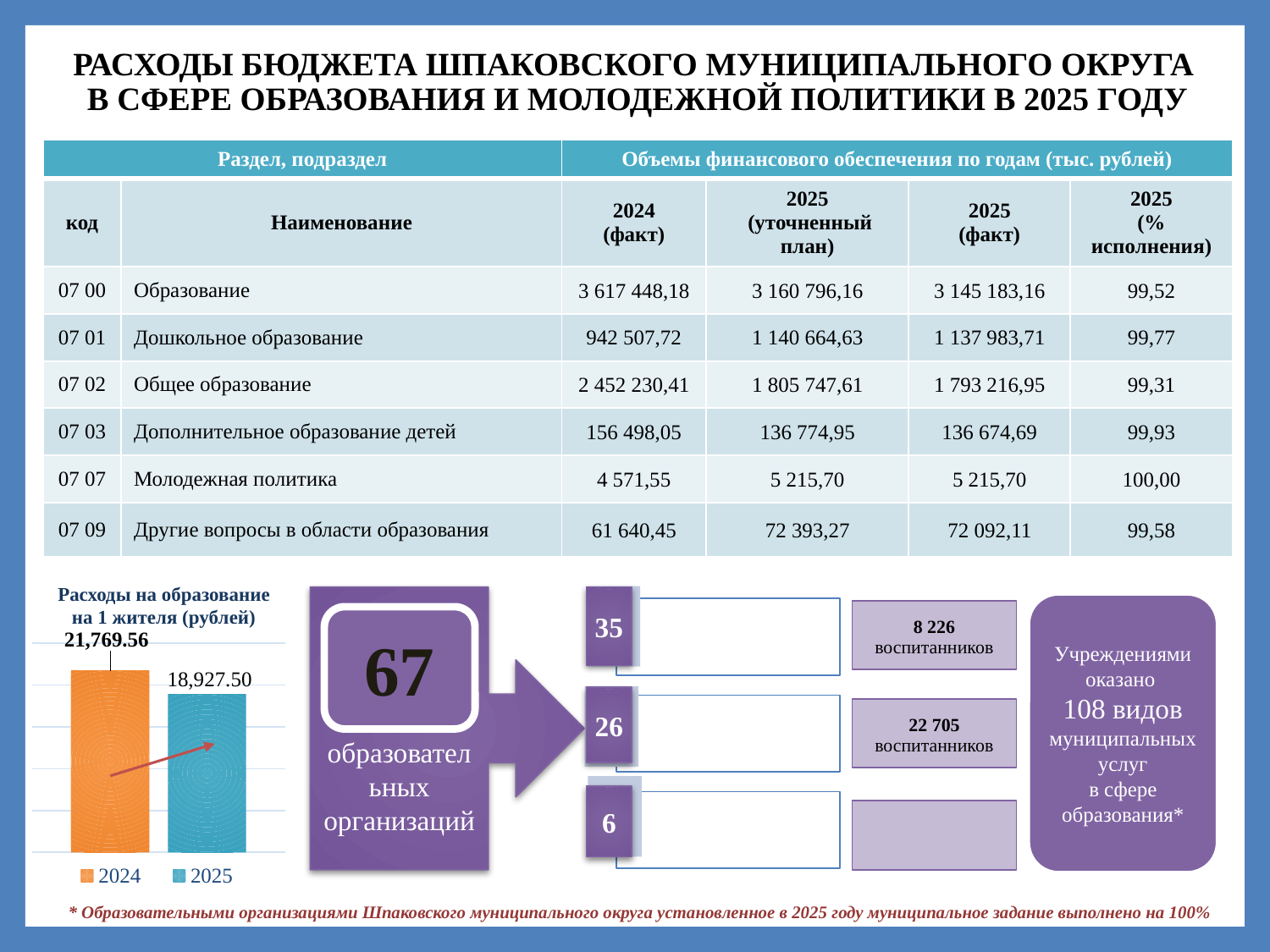
How many entries does the legend of the chart 'Расходы на образование на 1 жителя (рублей)' list? 2 In the chart 'Расходы на образование на 1 жителя (рублей)', what is the difference between the 2024 and 2025 values? 2,842.06 What is the value for 2024 in the chart 'Расходы на образование на 1 жителя (рублей)'? 21,769.56 How many bars are plotted in the chart 'Расходы на образование на 1 жителя (рублей)'? 2 In the chart 'Расходы на образование на 1 жителя (рублей)', what colour is the bar for 2024? orange What is the value for 2025 in the chart 'Расходы на образование на 1 жителя (рублей)'? 18,927.50 In the chart 'Расходы на образование на 1 жителя (рублей)', do the values rise or fall from 2024 to 2025? fall In the chart 'Расходы на образование на 1 жителя (рублей)', which year has the highest value? 2024 In the chart 'Расходы на образование на 1 жителя (рублей)', is the value for 2024 or 2025 larger? 2024 What kind of chart is 'Расходы на образование на 1 жителя (рублей)'? bar chart In the chart 'Расходы на образование на 1 жителя (рублей)', which year has the lowest value? 2025 What is the title of the bar chart in the lower left of the slide? Расходы на образование на 1 жителя (рублей)